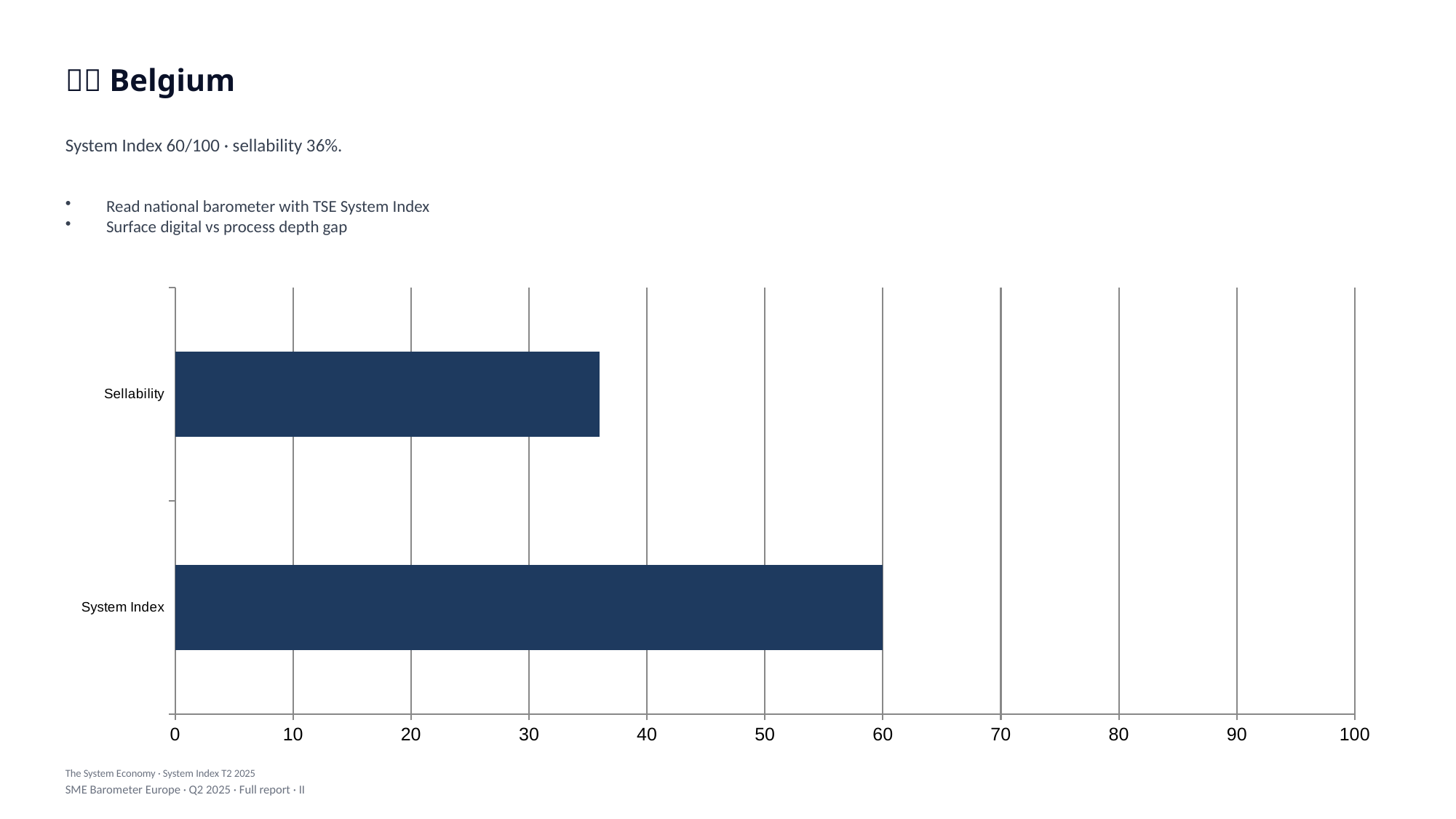
What is the value of the System Index bar? 60 Which category has the highest value? System Index How many categories are shown in the chart? 2 Which category has the lowest value? Sellability Is the value for System Index greater or less than 50? greater Is the value for Sellability greater or less than 40? less Which is larger, the System Index bar or the Sellability bar? System Index What country is named in the slide title? Belgium What is the maximum value shown on the horizontal axis? 100 What is the difference between the System Index value and the Sellability value? 24 What is the value of the Sellability bar? 36 What kind of chart is shown on the slide? Bar chart